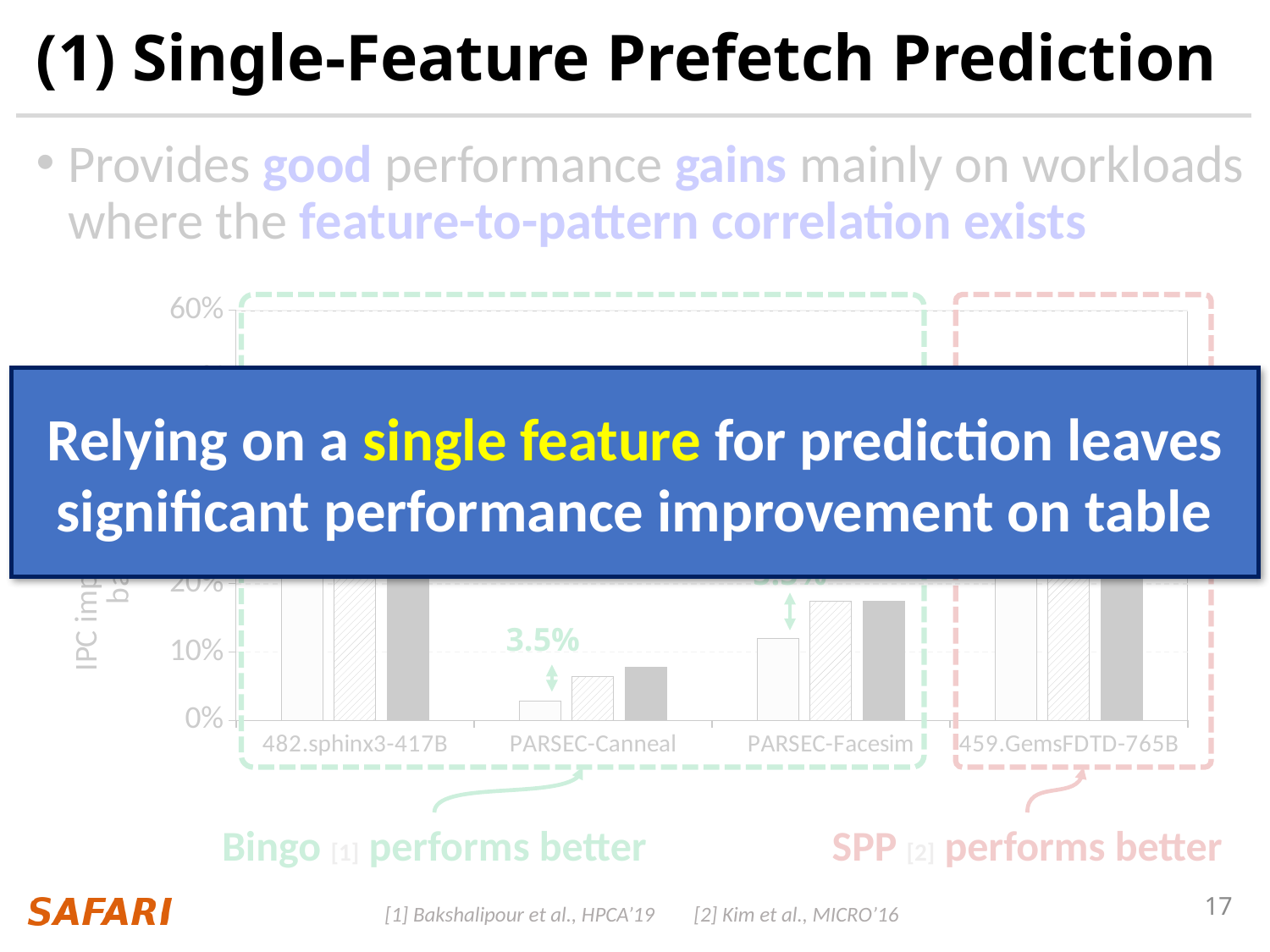
Is the value of the leftmost bar for 482.sphinx3-417B greater or less than 20%? greater Is the value of the rightmost bar for PARSEC-Facesim greater or less than 20%? less Is the value of the leftmost bar for PARSEC-Facesim greater or less than 10%? greater How many workload categories are shown on the x axis of the chart? 4 What kind of chart is shown on the slide? bar chart For PARSEC-Canneal, which is larger: the leftmost bar or the rightmost bar? the rightmost bar Which is larger: the rightmost bar for PARSEC-Facesim or the rightmost bar for PARSEC-Canneal? PARSEC-Facesim What percentage value is annotated above the PARSEC-Canneal bars? 3.5% What is the highest tick value shown on the y axis of the chart? 60% Which workload category is enclosed in the dashed box labeled 'SPP performs better'? 459.GemsFDTD-765B Which workload category has the lowest bars in the chart? PARSEC-Canneal